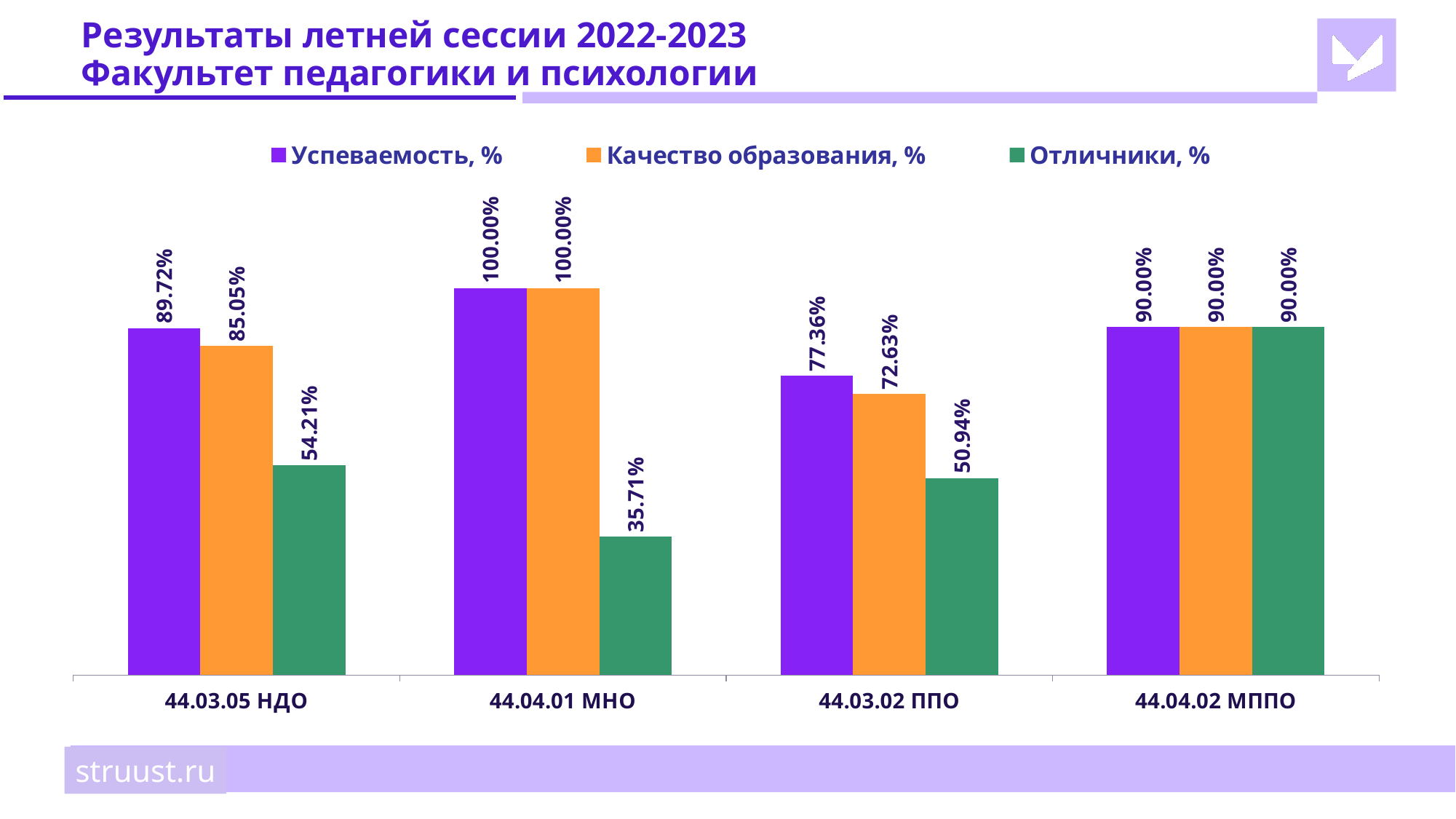
What is the value of Качество образования, % for 44.03.02 ППО? 72.63% Which colour represents the series Качество образования, % in the legend? Orange Which is larger: Отличники, % for 44.03.05 НДО or Отличники, % for 44.03.02 ППО? 44.03.05 НДО How many categories are shown on the x axis? 4 What is the value of Успеваемость, % for 44.03.05 НДО? 89.72% What kind of chart is shown on the slide? Bar chart What is the value of Отличники, % for 44.04.02 МППО? 90.00% Which category has the lowest value for Отличники, %? 44.04.01 МНО Which category has the highest value for Успеваемость, %? 44.04.01 МНО How many series does the legend list? 3 What is the value of Отличники, % for 44.04.01 МНО? 35.71% What is the difference between Успеваемость, % and Качество образования, % for 44.03.05 НДО? 4.67%